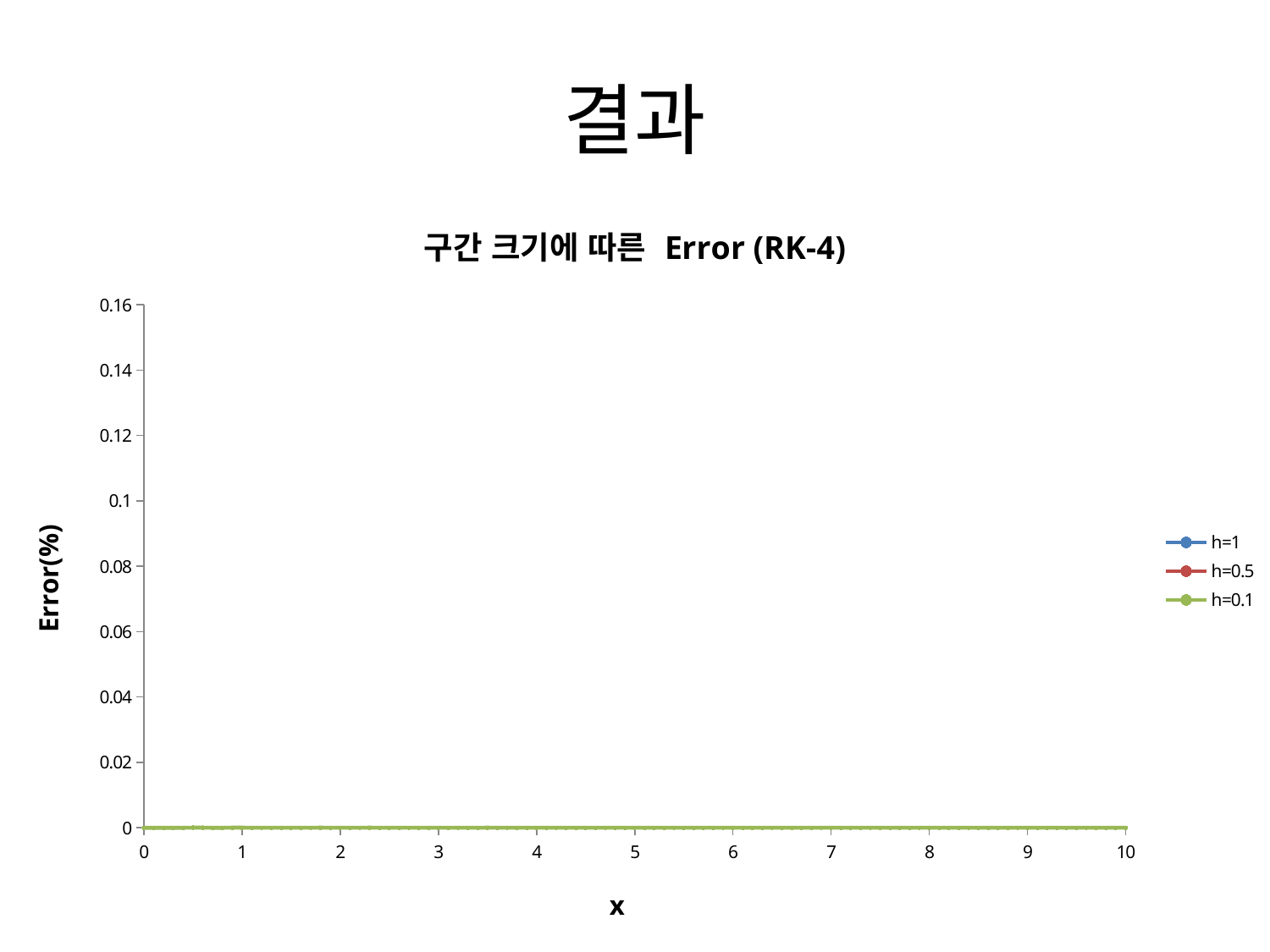
What kind of chart is shown on the slide? line chart Which series is drawn in green in the legend? h=0.1 Is the value for h=0.5 at x=8 greater or less than 0.04? less Do the plotted error values rise, fall, or stay flat as x increases from 0 to 10? stay flat What is the title of the chart? 구간 크기에 따른 Error (RK-4) What is the label of the vertical axis? Error(%) Is the value for h=1 at x=5 greater or less than 0.02? less Is the value for h=0.1 at x=2 greater or less than 0.02? less How many series does the legend list? 3